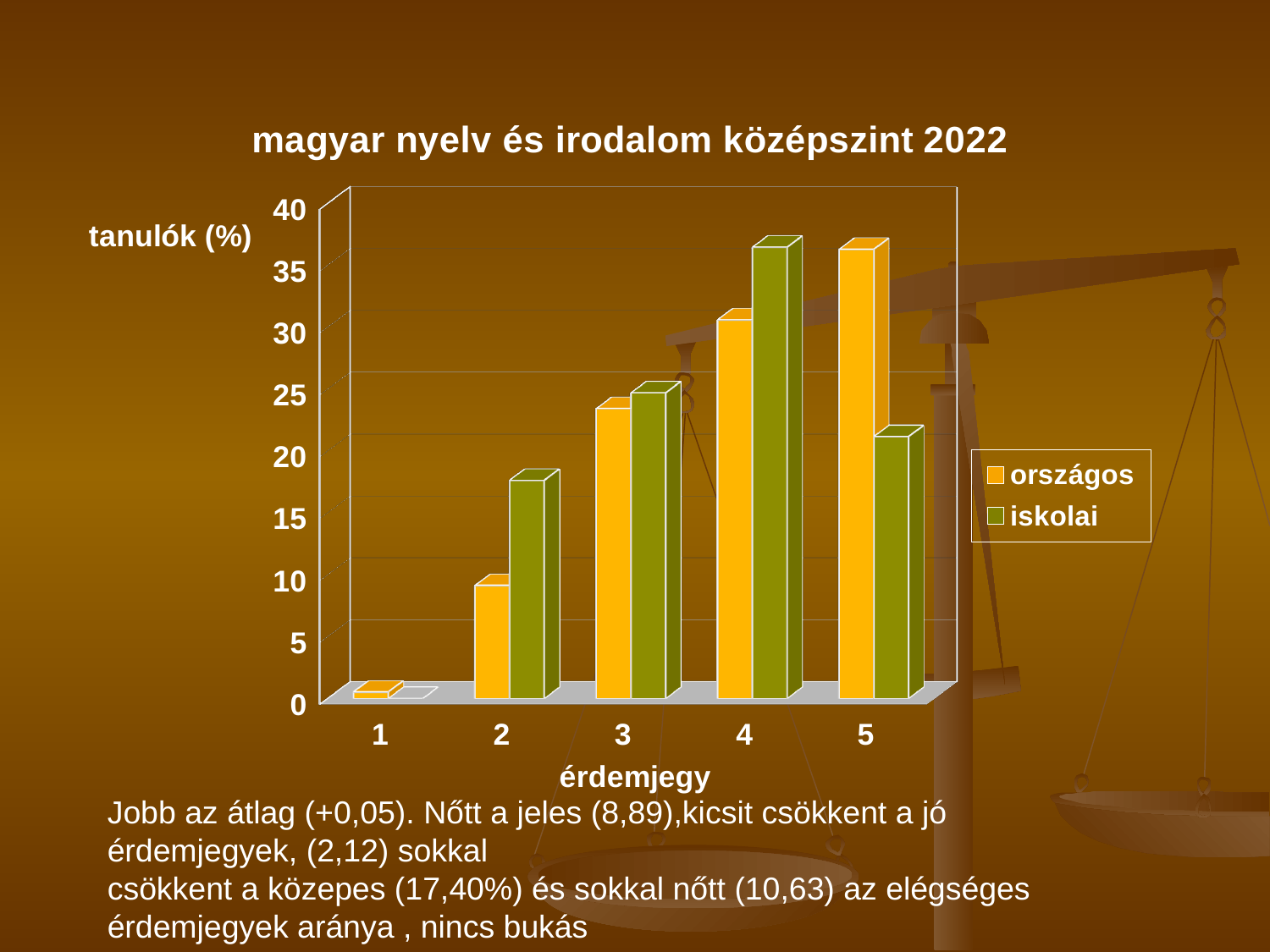
What is the label of the vertical axis? tanulók (%) How many series does the legend list? 2 Is the iskolai value for érdemjegy 4 greater or less than 30? greater For érdemjegy 5, which series has the larger value, országos or iskolai? országos What kind of chart is shown on the slide? bar chart For which érdemjegy is the iskolai value highest? 4 What is the title of the chart? magyar nyelv és irodalom középszint 2022 How many érdemjegy categories are shown on the x axis? 5 For which érdemjegy is the országos value highest? 5 Is the országos value for érdemjegy 2 greater or less than 10? less For érdemjegy 2, which series has the larger value, országos or iskolai? iskolai For which érdemjegy is the iskolai value lowest? 1